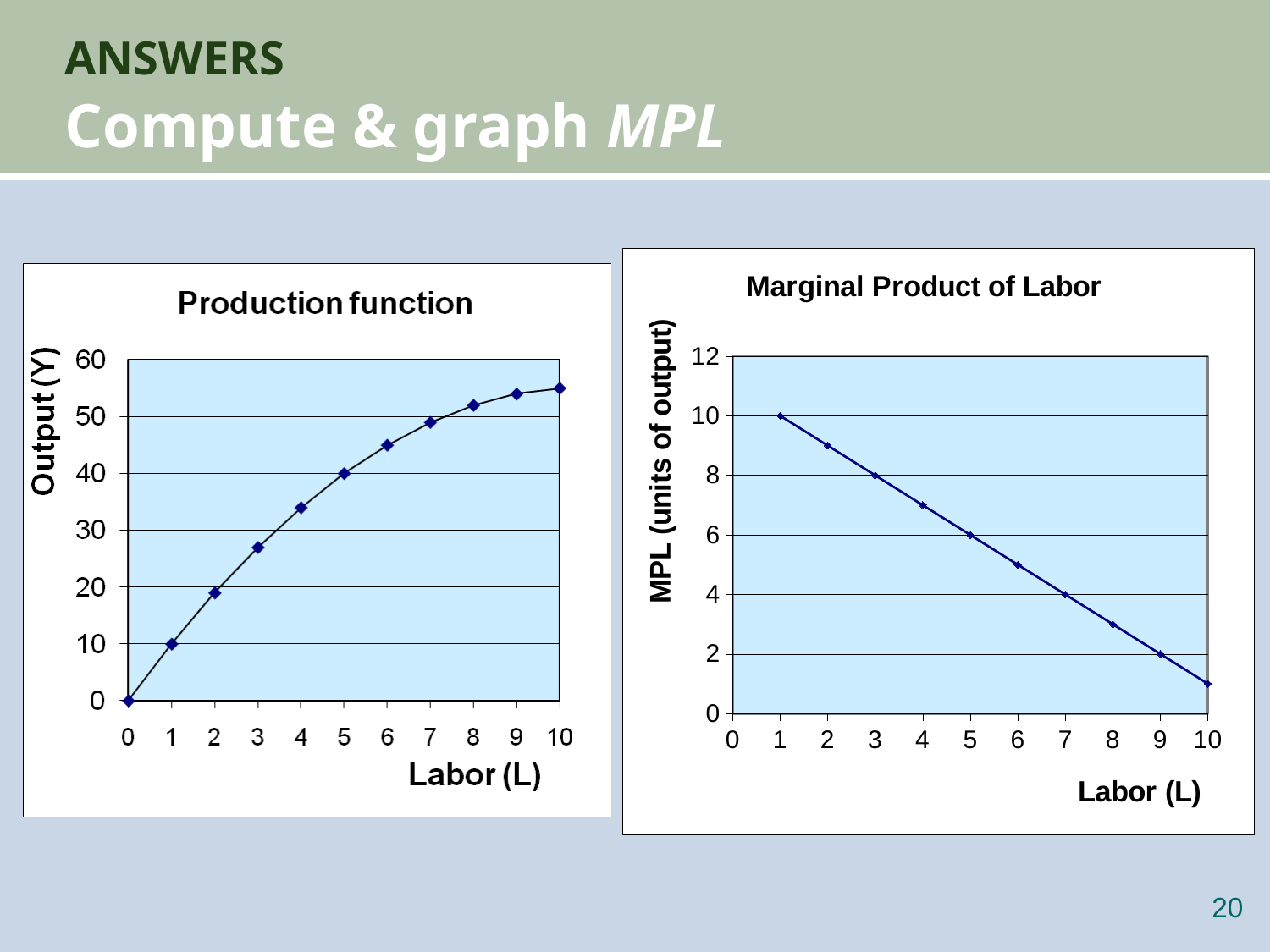
In the Marginal Product of Labor chart, what is MPL when labor (L) is 1? 10 What kind of chart is the Production function chart? line chart How many data points are plotted in the Production function chart? 11 In the Production function chart, what is the output (Y) when labor (L) is 1? 10 In the Production function chart, is the output at labor 8 greater or less than 50? greater In the Marginal Product of Labor chart, what is the difference between MPL at labor 1 and MPL at labor 5? 4 In the Marginal Product of Labor chart, what is MPL when labor (L) is 5? 6 In the Production function chart, does output rise or fall as labor increases? rise In the Production function chart, what is the output (Y) when labor (L) is 5? 40 In the Marginal Product of Labor chart, does MPL rise or fall as labor increases? fall In the Marginal Product of Labor chart, what is MPL when labor (L) is 9? 2 In the Marginal Product of Labor chart, at which labor value is MPL highest? 1